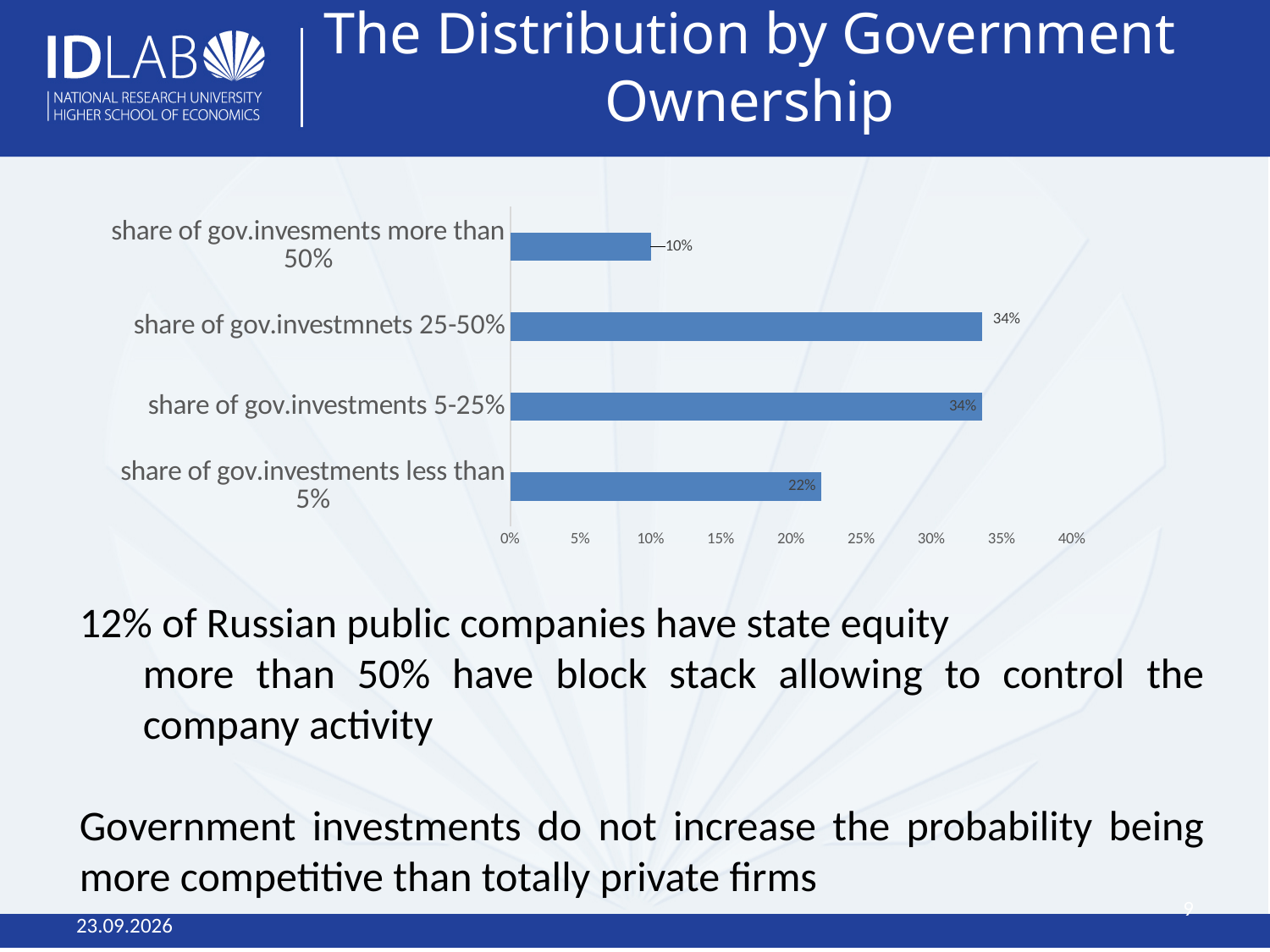
What is the value for the category 'share of gov.investments more than 50%'? 10% Which is larger: the value for 'share of gov.investments less than 5%' or the value for 'share of gov.investments more than 50%'? share of gov.investments less than 5% Is the value for 'share of gov.investments less than 5%' greater or less than 20%? greater What is the value for the category 'share of gov.investments 25-50%'? 34% What is the difference between the value for 'share of gov.investments 5-25%' and the value for 'share of gov.investments less than 5%'? 12% How many categories are shown in the chart? 4 Is the value for 'share of gov.investments more than 50%' greater or less than 15%? less Which category has the lowest value? share of gov.investments more than 50% What is the value for the category 'share of gov.investments less than 5%'? 22% What is the value for the category 'share of gov.investments 5-25%'? 34% What is the difference between the value for 'share of gov.investments less than 5%' and the value for 'share of gov.investments more than 50%'? 12% What kind of chart is shown on the slide? bar chart